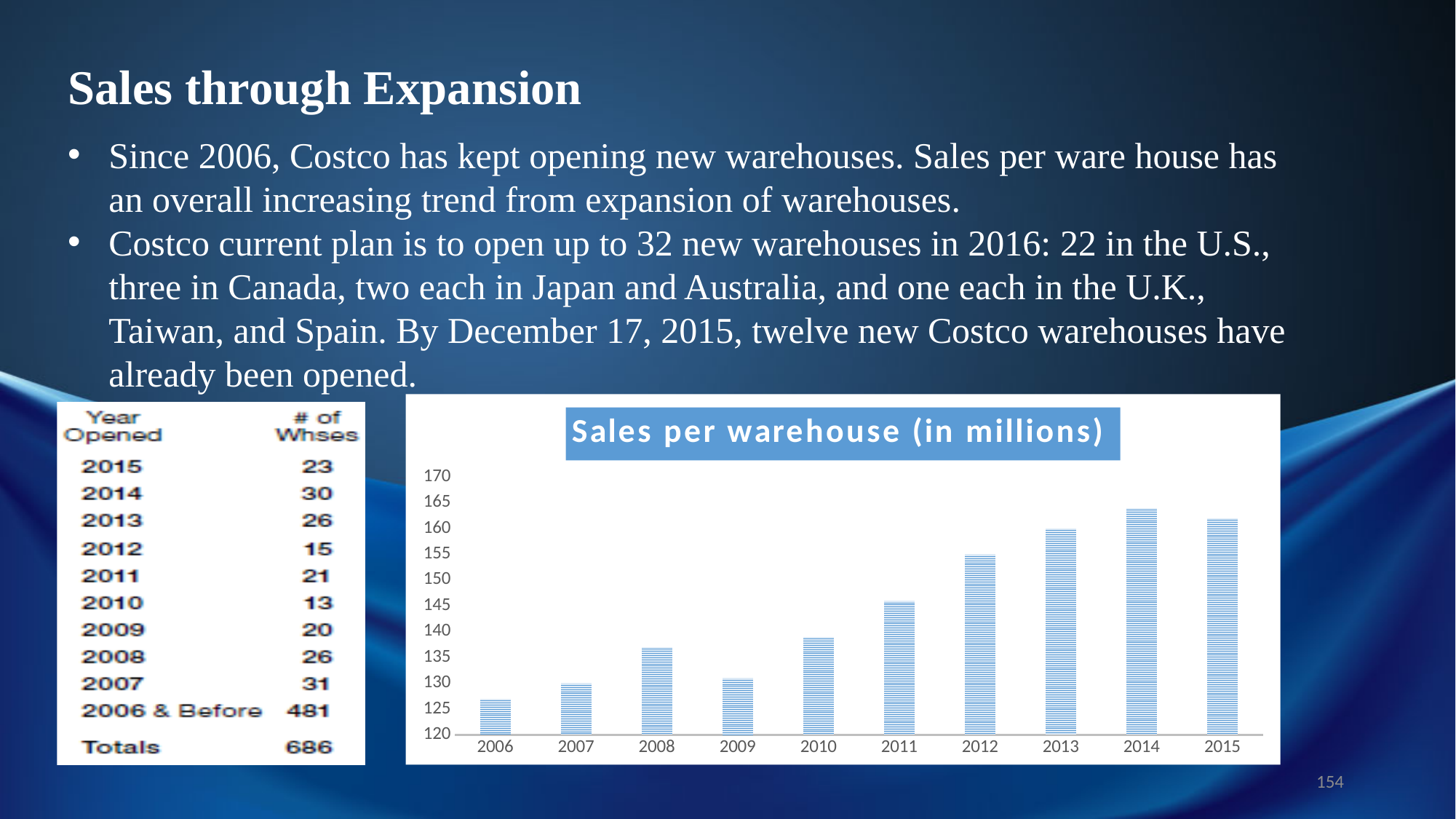
What kind of chart is shown on the slide? Bar chart Which year has the lowest sales per warehouse in the chart? 2006 Is the sales per warehouse value for 2006 greater or less than 130? less Is the sales per warehouse value for 2014 greater or less than 160? greater Which year has higher sales per warehouse, 2008 or 2009? 2008 Is the sales per warehouse value for 2012 greater or less than 150? greater How many years are plotted in the Sales per warehouse chart? 10 Which year has the highest sales per warehouse in the chart? 2014 What is the title of the chart on the slide? Sales per warehouse (in millions) Do sales per warehouse generally rise or fall from 2006 to 2015 in the chart? Rise Which year has higher sales per warehouse, 2013 or 2015? 2015